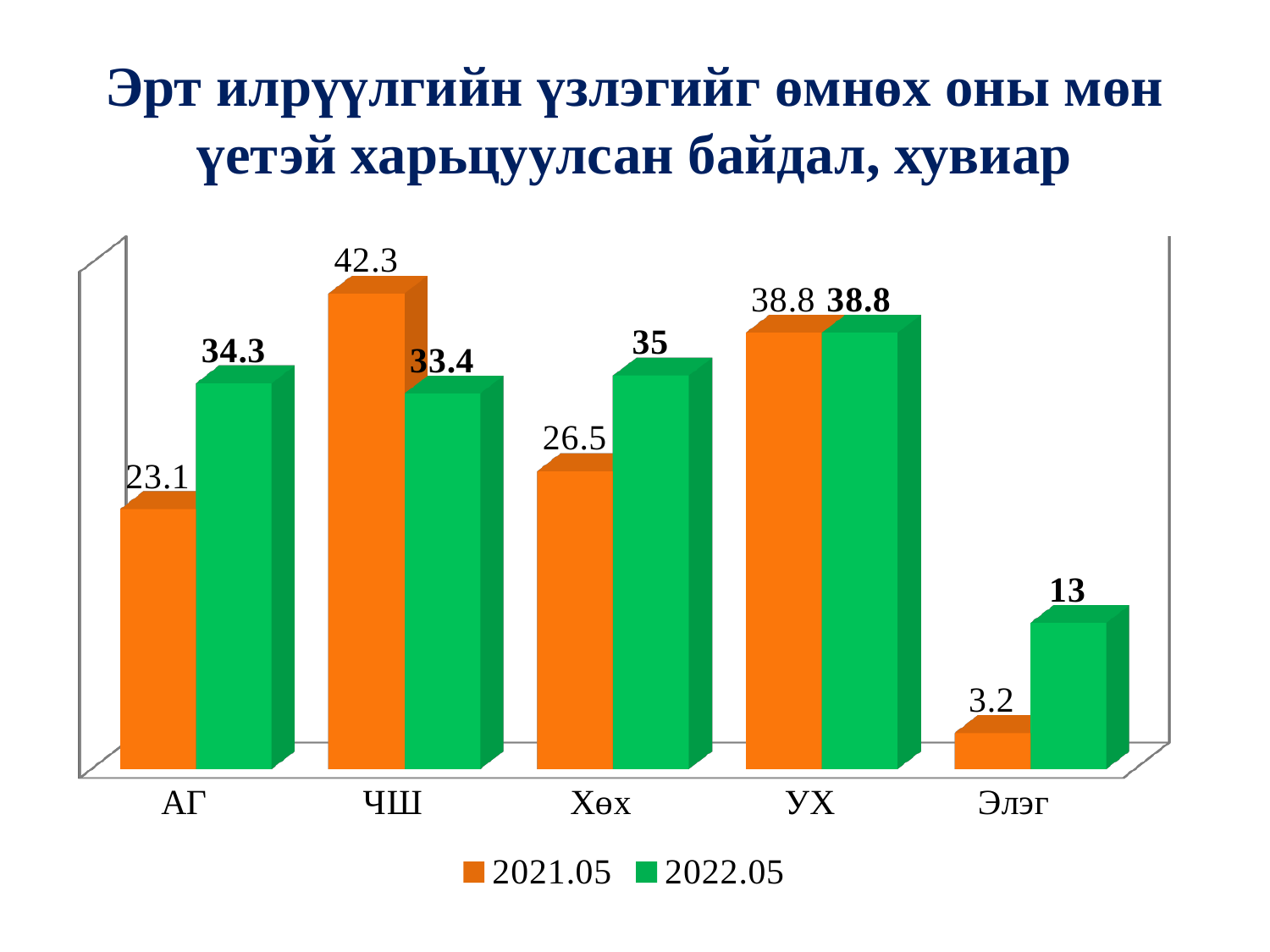
How many series does the legend list? 2 What is the value for Элэг in the 2022.05 series? 13 What is the value for Хөх in the 2021.05 series? 26.5 Which category has the highest value in the 2021.05 series? ЧШ How many categories are shown on the x axis? 5 What is the difference between the 2022.05 and 2021.05 values for АГ? 11.2 Which category has the lowest value in the 2022.05 series? Элэг Which is larger for ЧШ: the 2021.05 value or the 2022.05 value? 2021.05 What is the value for ЧШ in the 2021.05 series? 42.3 Which colour represents the 2022.05 series? Green What is the value for АГ in the 2022.05 series? 34.3 What kind of chart is shown on the slide? Bar chart